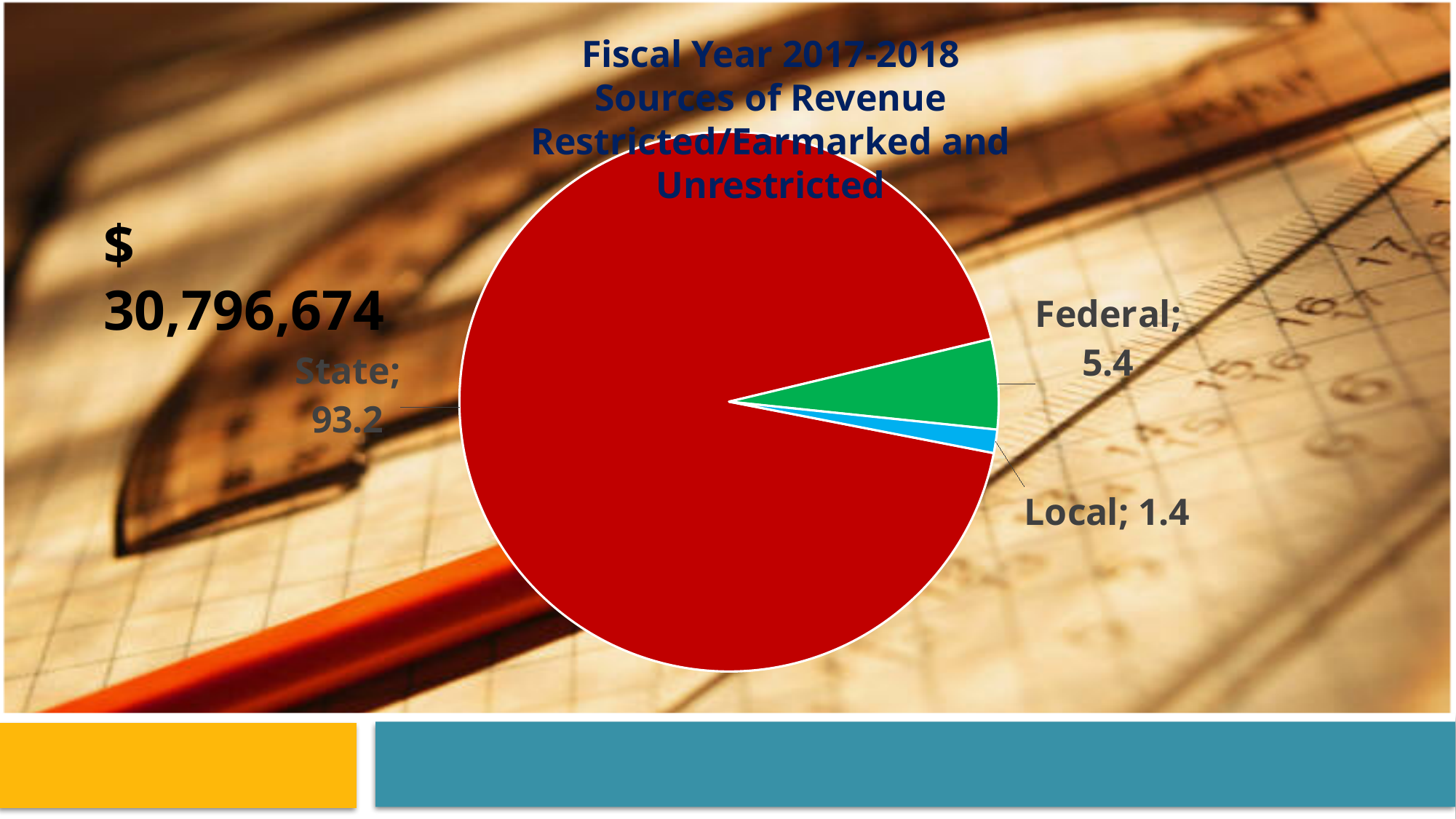
How many slices does the pie chart have? 3 Which source of revenue has the largest slice? State What is the value for Federal? 5.4 What is the value for State? 93.2 What is the difference between the State and Federal values? 87.8 Which source of revenue has the smallest slice? Local Which is larger, Federal or Local? Federal What is the difference between the Federal and Local values? 4.0 What kind of chart is shown on the slide? Pie chart What is the title of the chart? Fiscal Year 2017-2018 Sources of Revenue Restricted/Earmarked and Unrestricted What is the value for Local? 1.4 What colour is the State slice? Red